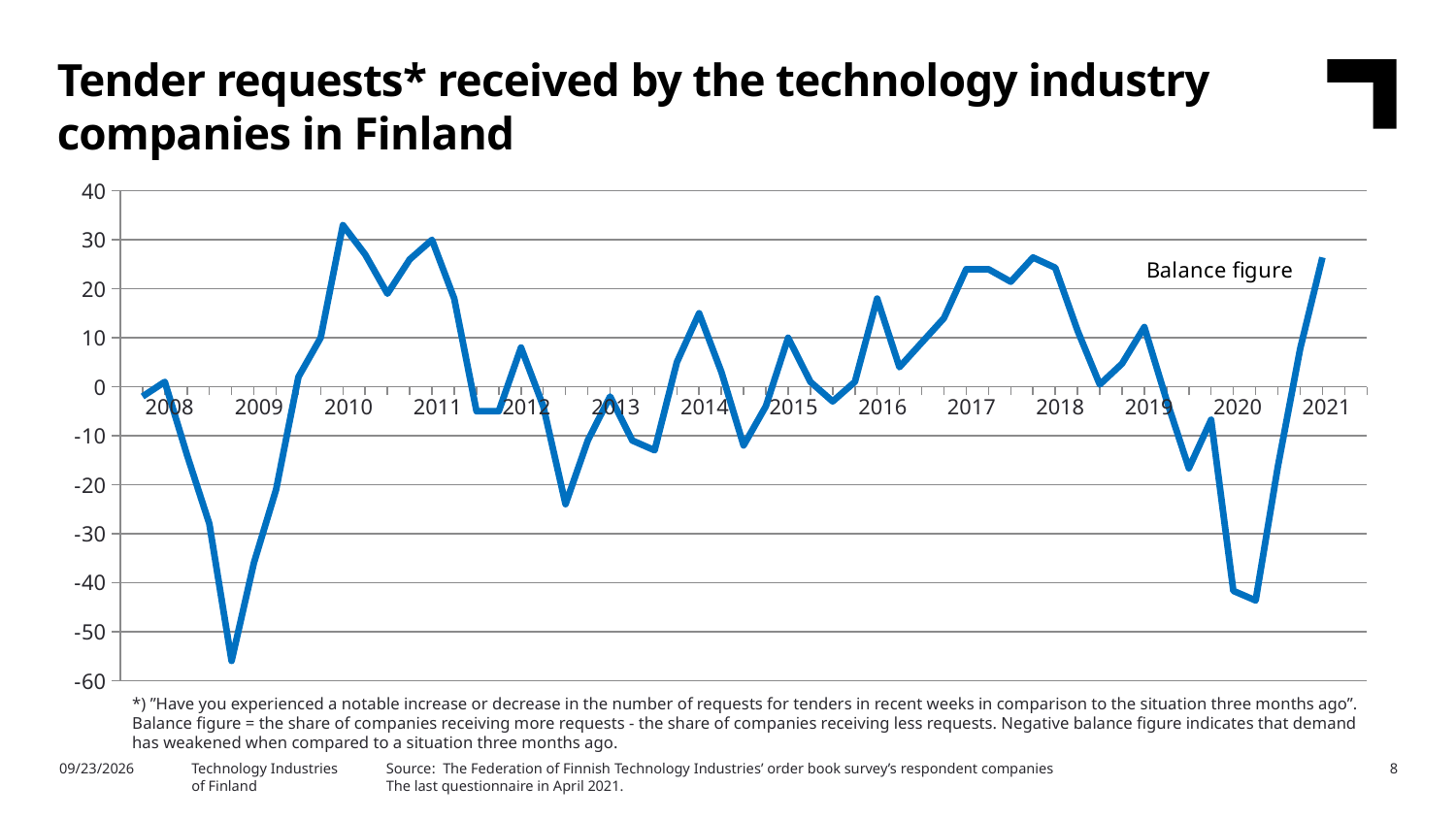
Does the balance figure rise or fall from its 2020 low point to the end of the series in 2021? rise Is the lowest value of the balance figure in 2009 greater or less than -50? less Is the peak value of the balance figure in 2010 greater or less than 30? greater In which year does the balance figure reach its lowest point? 2009 Is the lowest value of the balance figure in 2020 greater or less than -40? less Which is larger: the peak balance figure in 2010 or the peak balance figure in 2017? 2010 In which year does the balance figure reach its highest point? 2010 Does the balance figure rise or fall between 2008 and the low point in 2009? fall What is the name of the series plotted on the chart? Balance figure How many years are labelled on the x axis of the chart? 14 What kind of chart is shown on the slide? line chart